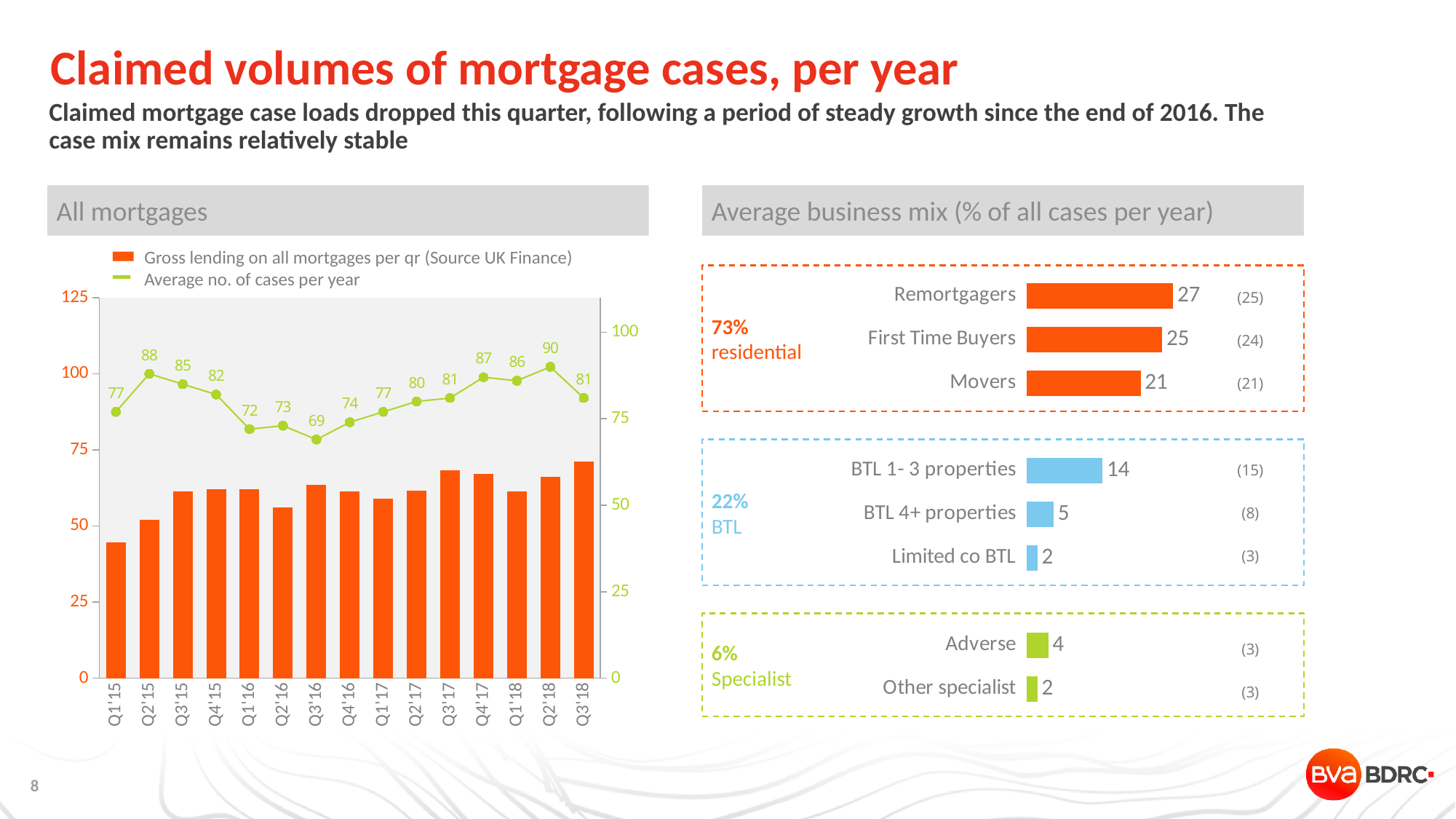
In the 'Average business mix' chart, what percentage of cases are Remortgagers? 27 In the 'Average business mix' chart, which is larger: BTL 1- 3 properties or BTL 4+ properties? BTL 1- 3 properties In the 'All mortgages' chart, how many series does the legend list? 2 In the 'All mortgages' chart, how many quarters are shown on the x axis? 15 In the 'All mortgages' chart, by how much did the average number of cases per year fall from Q2'18 to Q3'18? 9 In the 'Average business mix' chart, what is the difference between Remortgagers and Movers? 6 In the 'All mortgages' chart, which quarter has the lowest average number of cases per year? Q3'16 In the 'All mortgages' chart, what is the average number of cases per year shown for Q2'18? 90 What kind of chart is the 'Average business mix' chart? bar chart In the 'All mortgages' chart, which quarter has the highest average number of cases per year? Q2'18 In the 'All mortgages' chart, is the gross lending bar for Q1'15 greater or less than 50? less In the 'Average business mix' chart, which category has the highest value? Remortgagers